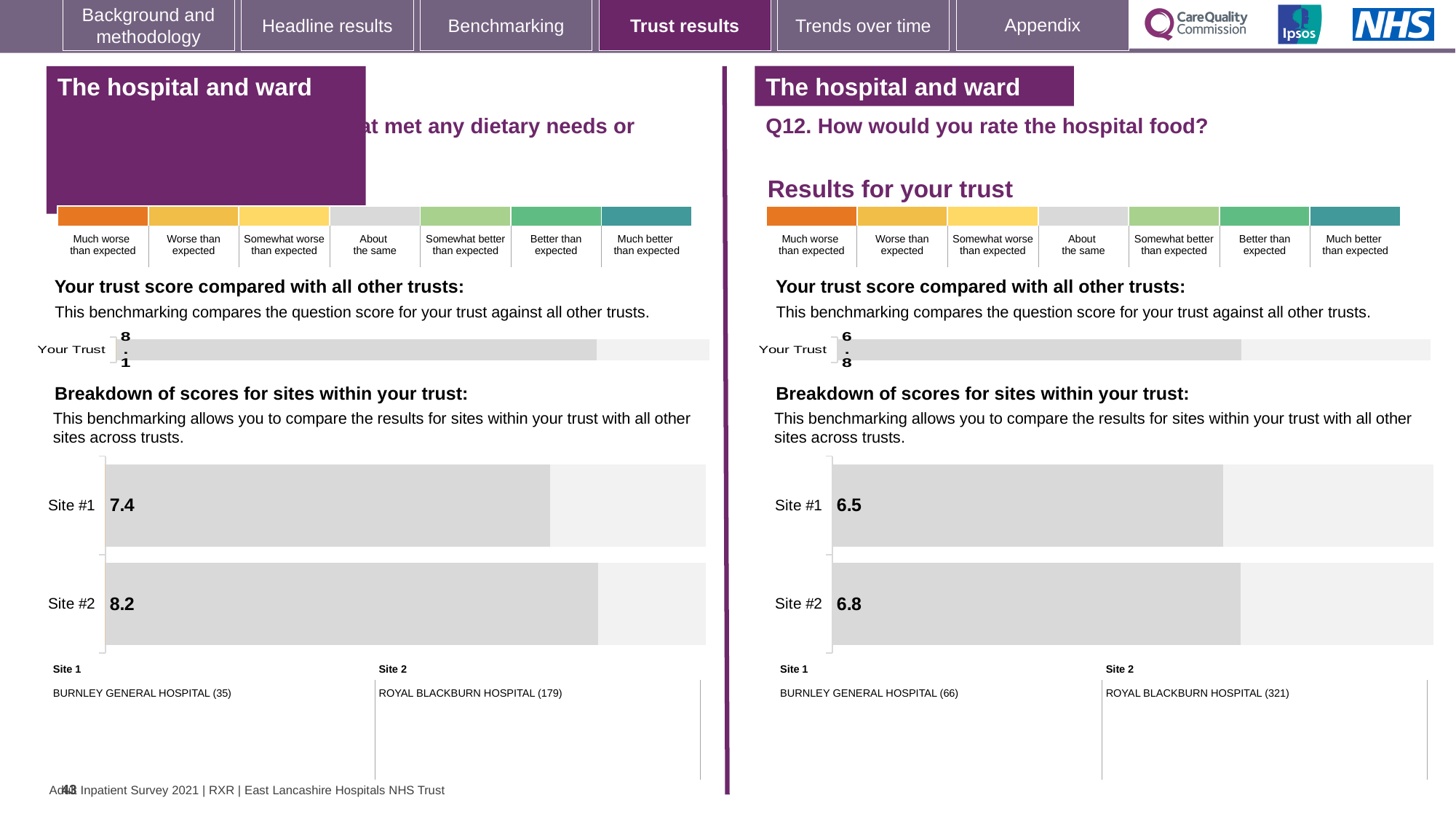
What type of chart is used for the breakdown of scores for sites within your trust on the left-hand slide? Bar chart On the right-hand slide's (Q12) site breakdown chart, what is the difference between the Site #2 score and the Site #1 score? 0.3 On the right-hand slide (Q12, hospital food), what is the score for Site #1 in the breakdown of scores for sites within your trust? 6.5 On the left-hand slide's site breakdown chart, which site has the higher score? Site #2 On the left-hand slide's site breakdown chart, what is the difference between the Site #2 score and the Site #1 score? 0.8 On the right-hand slide's (Q12) site breakdown chart, which site has the lower score? Site #1 On the right-hand slide (Q12, hospital food), what is the score for Site #2 in the breakdown of scores for sites within your trust? 6.8 On the left-hand slide, what is the score for Site #1 in the breakdown of scores for sites within your trust? 7.4 How many sites are shown in the site breakdown chart on the right-hand slide (Q12)? 2 On the right-hand slide (Q12, hospital food), what is the 'Your Trust' score shown in the trust score comparison chart? 6.8 On the left-hand slide, what is the 'Your Trust' score shown in the trust score comparison chart? 8.1 On the left-hand slide, what is the score for Site #2 in the breakdown of scores for sites within your trust? 8.2